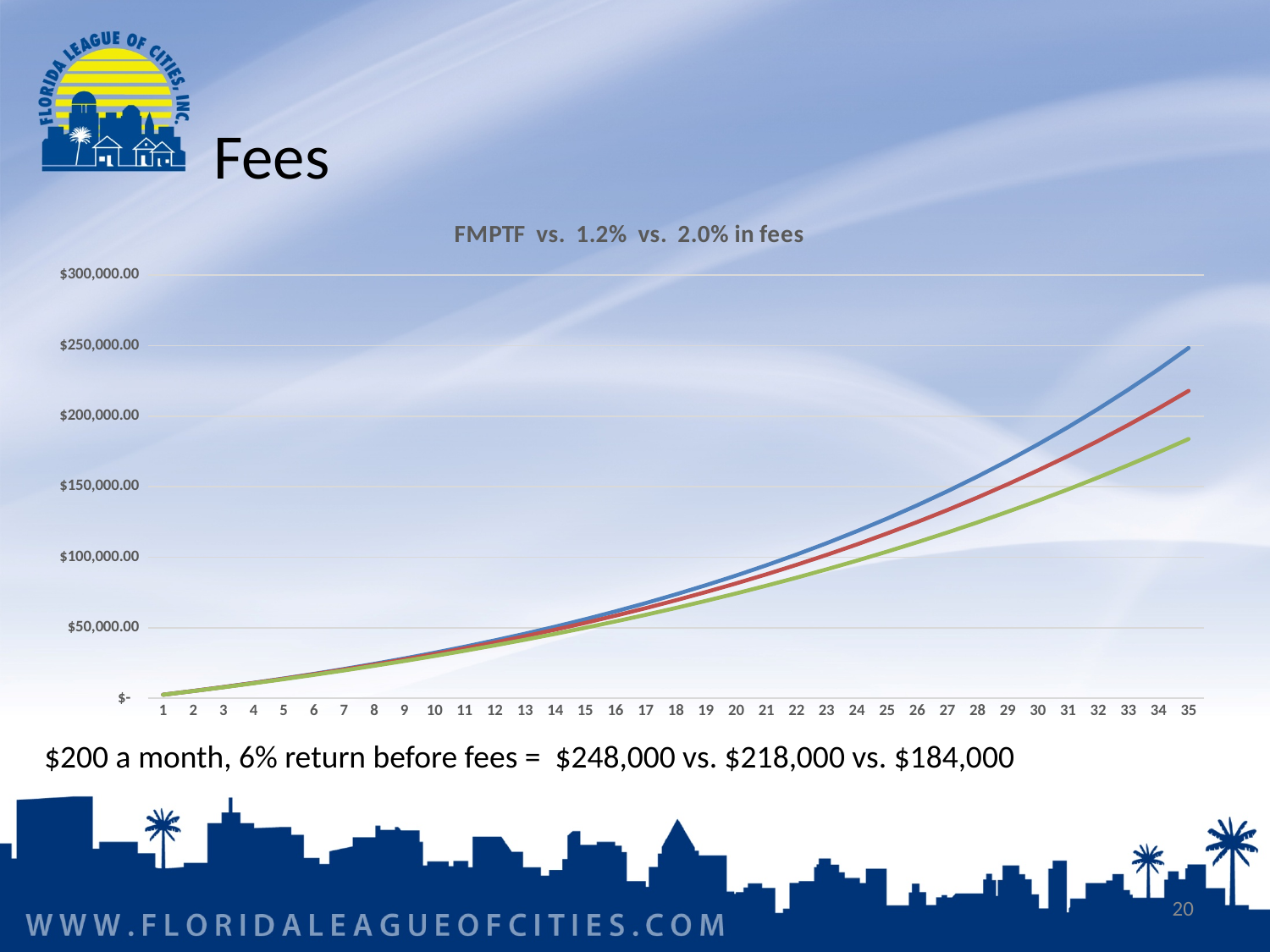
How many points are on the x axis of the chart? 35 Do the values of the lines rise or fall as the x axis goes from 1 to 35? rise What is the title of the chart? FMPTF vs. 1.2% vs. 2.0% in fees At point 35, is the value of the green line greater or less than $200,000.00? less At point 35, is the value of the blue line greater or less than $200,000.00? greater What kind of chart is shown on the slide? line chart Which line has the lowest value at point 35? the green line How many lines are plotted on the chart? 3 Which line has the highest value at point 35? the blue line At point 35, is the value of the green line greater or less than $150,000.00? greater At point 35, which is larger, the value of the blue line or the value of the red line? the blue line